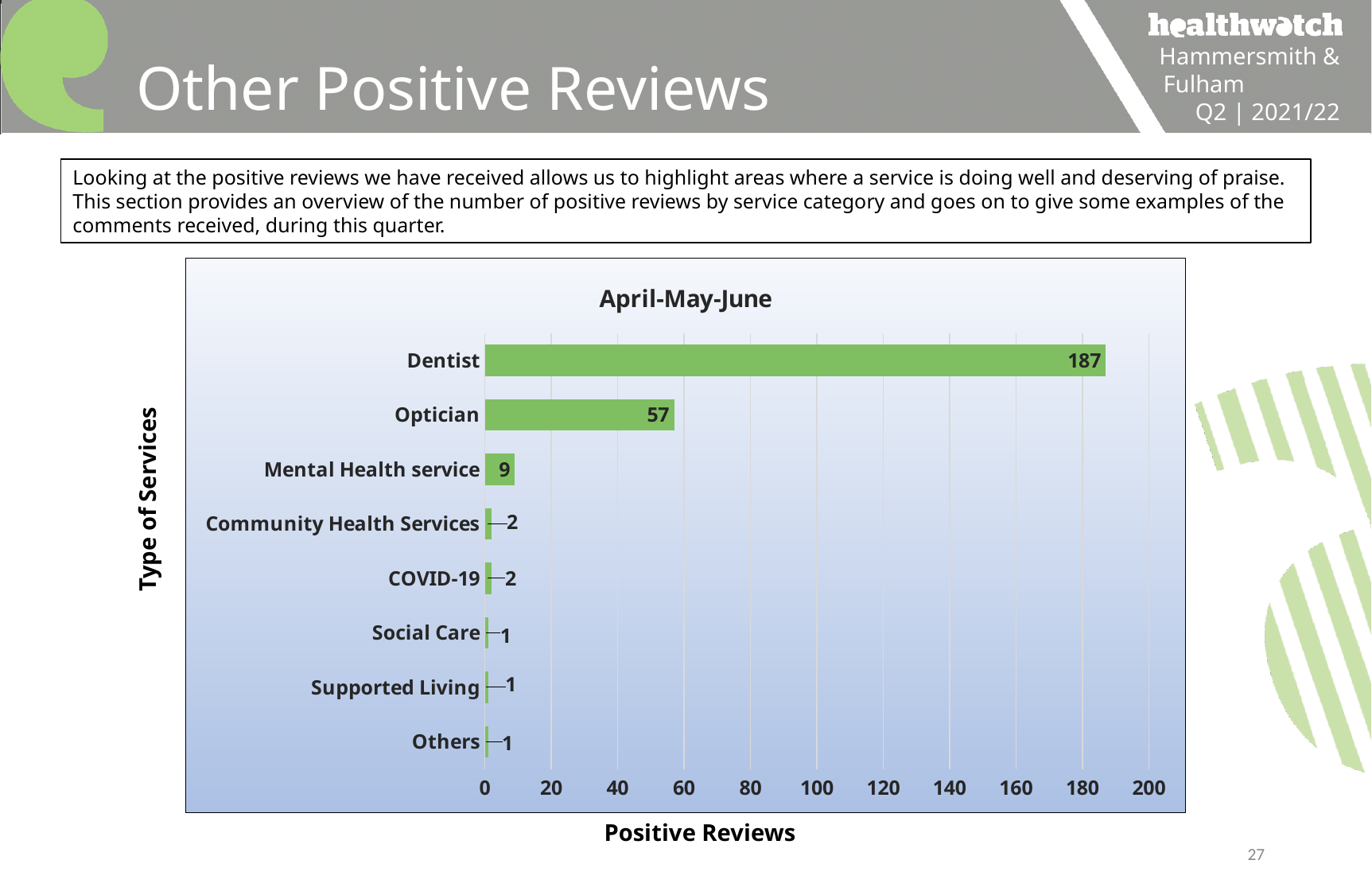
Is the value for Dentist greater or less than 180? greater What is the value for COVID-19? 2 How many positive reviews did Mental Health service receive? 9 How many types of services are shown in the chart? 8 What is the value for Optician? 57 What is the title of the chart? April-May-June Which type of service has the highest number of positive reviews? Dentist What is the difference in positive reviews between Dentist and Optician? 130 What kind of chart is shown on the slide? Bar chart Which has more positive reviews, Optician or Mental Health service? Optician What is the label of the horizontal axis? Positive Reviews How many positive reviews did Dentist receive? 187